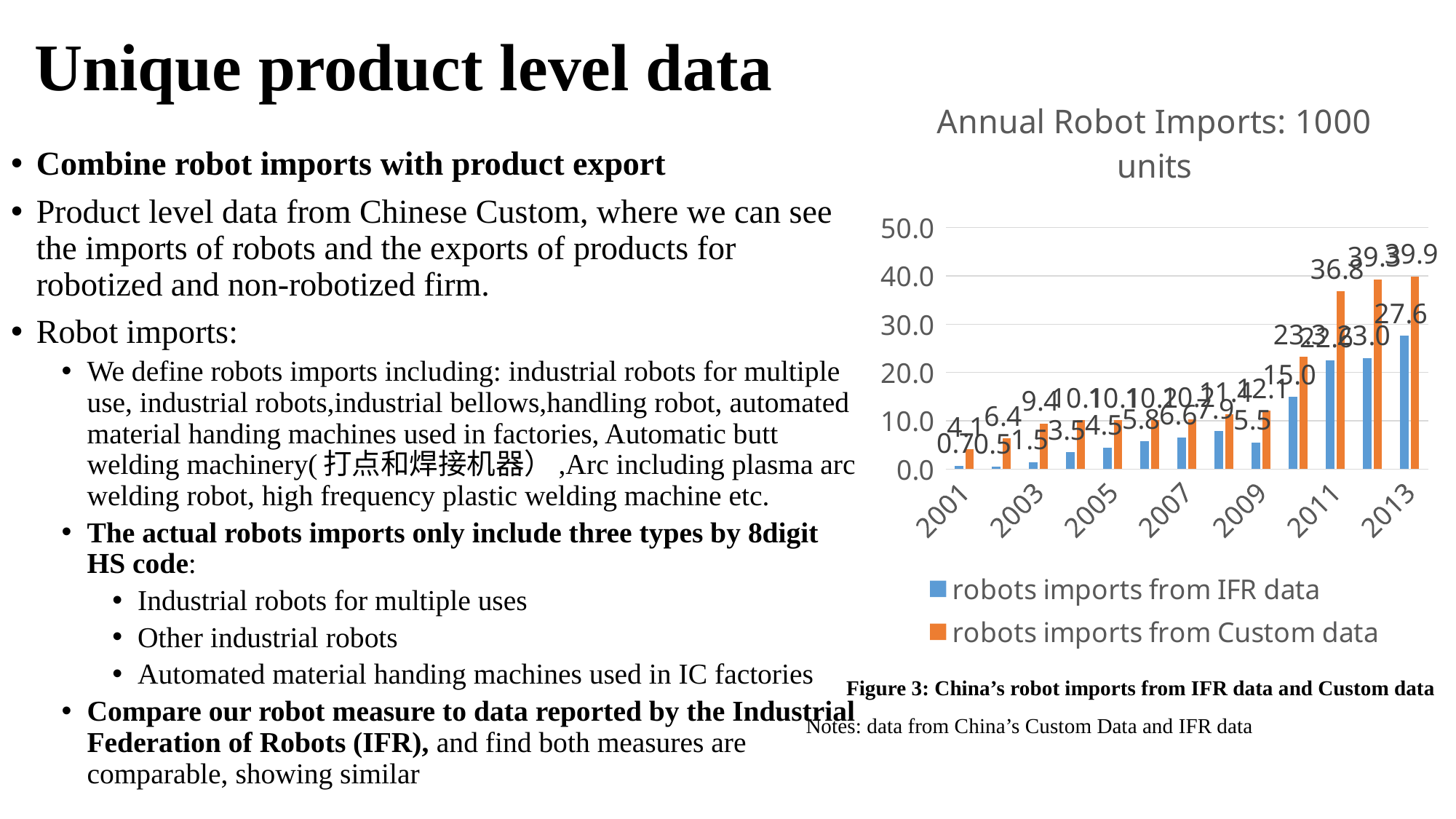
What is the value of robots imports from Custom data in 2011? 36.8 What is the value of robots imports from IFR data in 2013? 27.6 What is the difference between robots imports from Custom data and from IFR data in 2013? 12.3 Which year has the lowest value for robots imports from Custom data? 2001 How many series does the chart legend list? 2 How many years are plotted on the x axis of the chart? 13 What is the value of robots imports from Custom data in 2013? 39.9 What type of chart is shown on the slide? bar chart Which year has the highest value for robots imports from IFR data? 2013 Is the value for robots imports from IFR data in 2011 greater or less than 20.0? greater What is the value of robots imports from IFR data in 2001? 0.7 What is the title of the chart? Annual Robot Imports: 1000 units